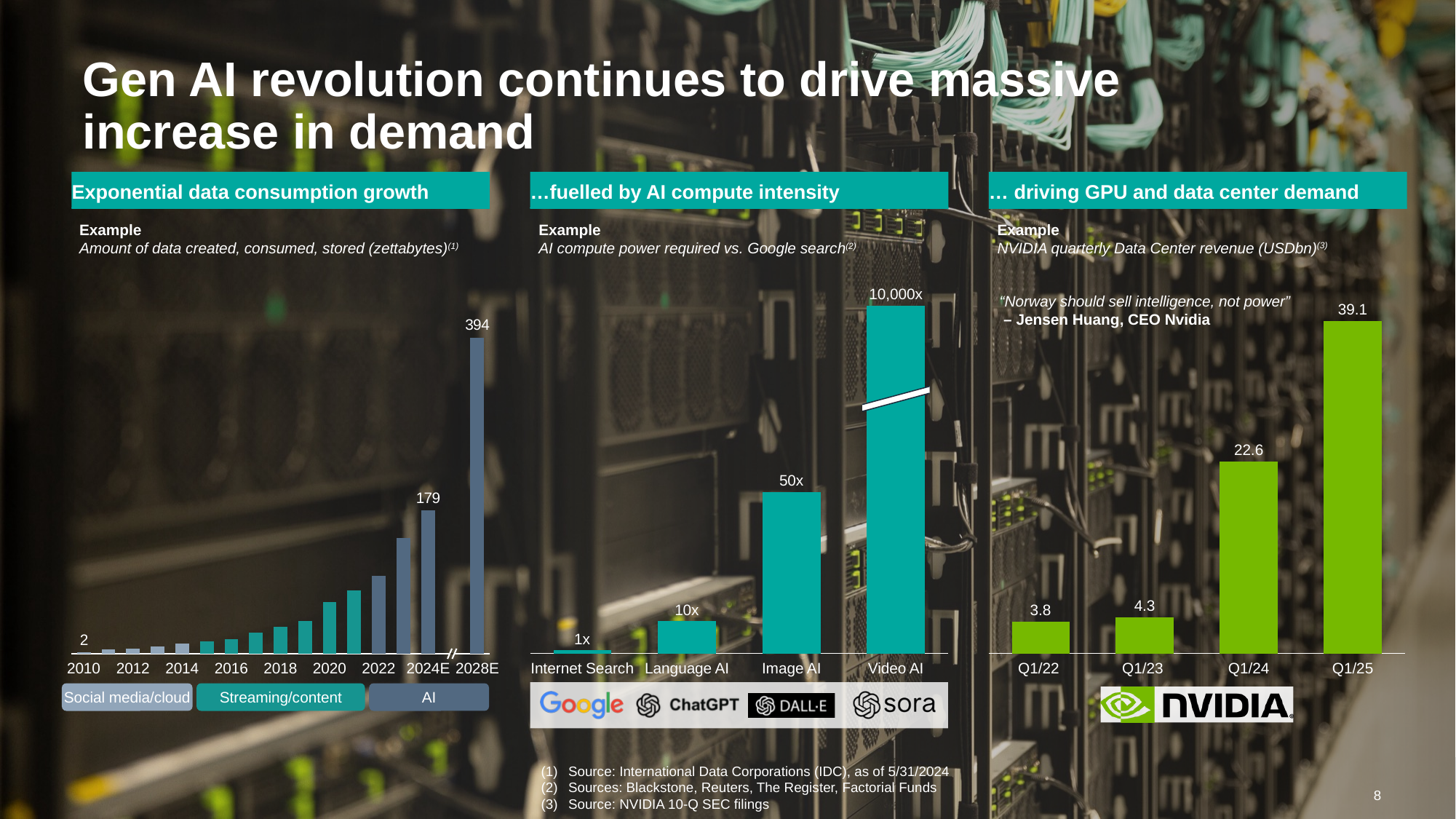
In the chart titled 'Exponential data consumption growth', how many entries does the legend list? 3 What kind of chart is the one titled '…fuelled by AI compute intensity'? bar chart In the chart titled 'Exponential data consumption growth', what is the difference between the 2028E and 2024E values? 215 In the chart titled '…fuelled by AI compute intensity', which is larger, Image AI or Language AI? Image AI In the chart titled '… driving GPU and data center demand', what is the value for Q1/23? 4.3 In the chart titled '…fuelled by AI compute intensity', what is the value for Video AI? 10,000x In the chart titled '… driving GPU and data center demand', what is the difference between the Q1/25 and Q1/24 values? 16.5 In the chart titled '… driving GPU and data center demand', do the values rise or fall from Q1/22 to Q1/25? rise In the chart titled 'Exponential data consumption growth', what is the value for 2028E? 394 In the chart titled '… driving GPU and data center demand', which quarter has the lowest value? Q1/22 In the chart titled '… driving GPU and data center demand', what is the value for Q1/25? 39.1 In the chart titled '…fuelled by AI compute intensity', how many categories are shown on the x axis? 4